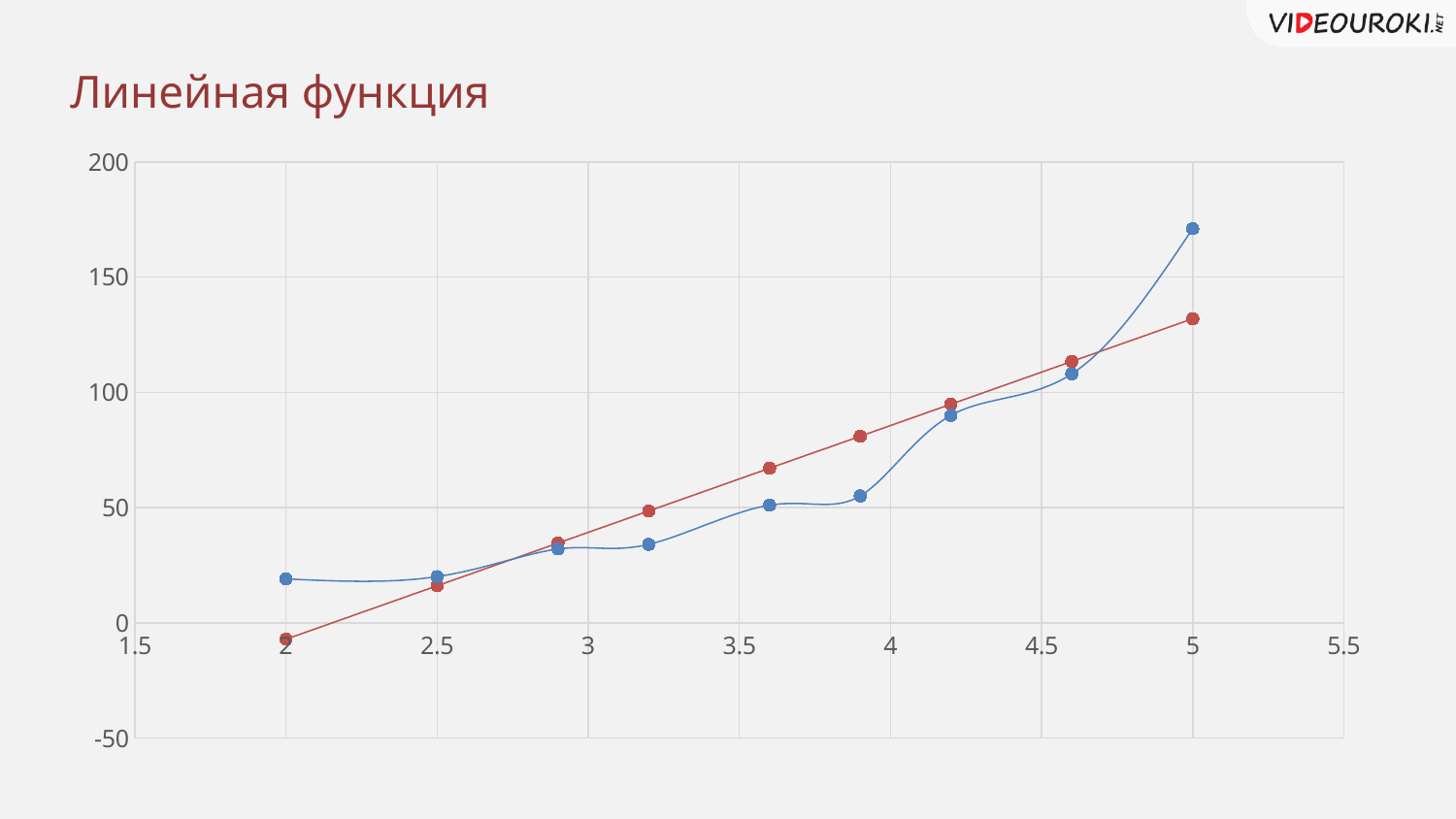
Is the value of the red series at x = 3.9 greater or less than 50? greater At x = 2, which series has the higher value, the blue or the red? blue Is the value of the red series at x = 2 greater or less than 0? less What kind of chart is shown on the slide? scatter chart with lines and markers How many data points does the blue series have? 9 How many data series are plotted on the chart? 2 What is the title of the chart? Линейная функция At x = 3.6, which series has the higher value, the blue or the red? red Is the value of the red series at x = 5 greater or less than 150? less At x = 5, which series has the higher value, the blue or the red? blue Do the values of the red series rise or fall as x increases? rise